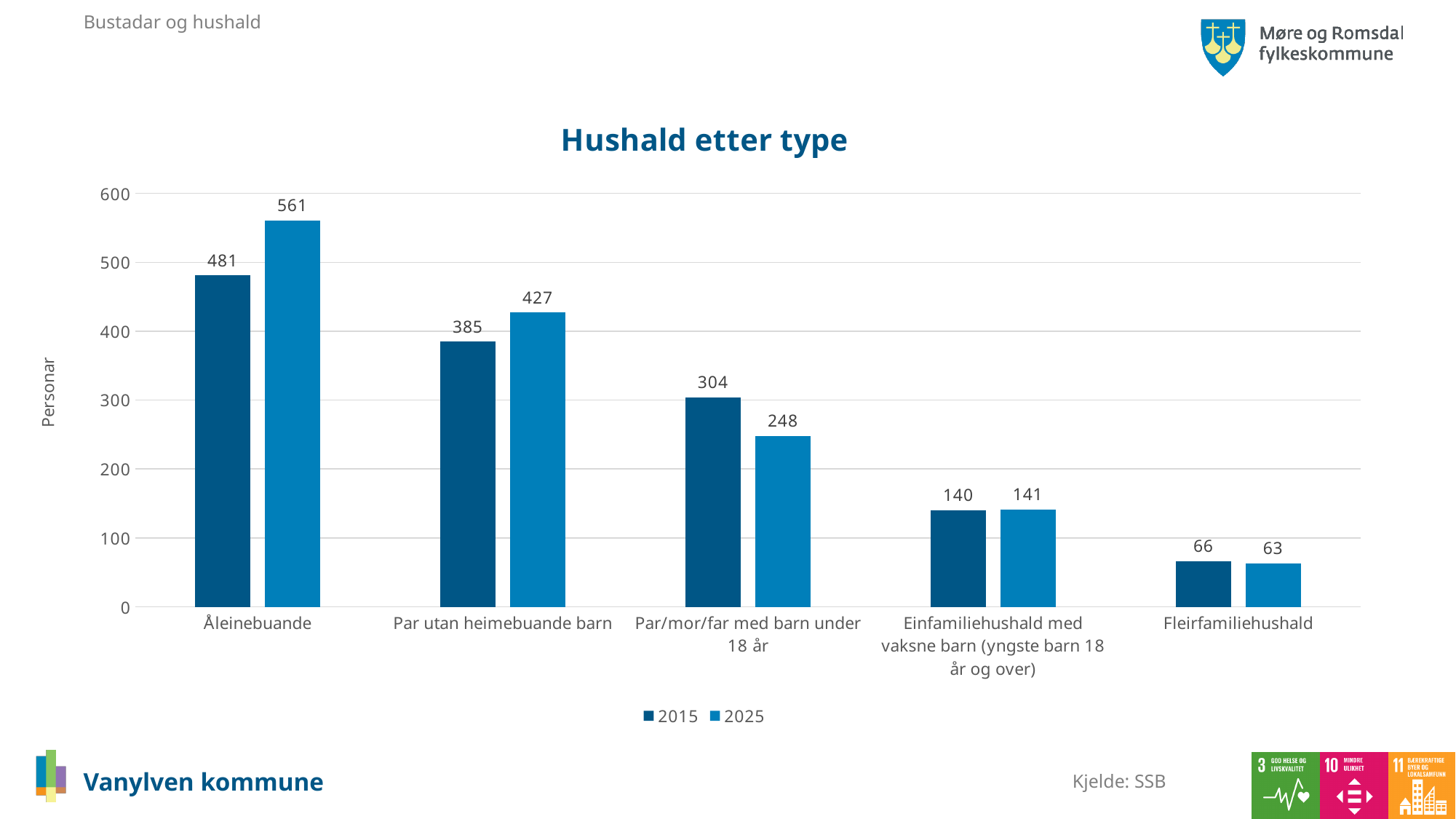
What is the title of the chart? Hushald etter type What is the difference between the 2025 and 2015 values for Åleinebuande? 80 What is the value for Åleinebuande in 2025? 561 Which is larger for Par utan heimebuande barn: the 2015 value or the 2025 value? 2025 What is the difference between the 2015 and 2025 values for Par/mor/far med barn under 18 år? 56 What is the value for Fleirfamiliehushald in 2025? 63 What kind of chart is shown on the slide? Bar chart What is the value for Par utan heimebuande barn in 2015? 385 How many series does the legend list? 2 Which category has the highest value in 2015? Åleinebuande Which category has the lowest value in 2025? Fleirfamiliehushald How many household categories are shown on the x axis? 5